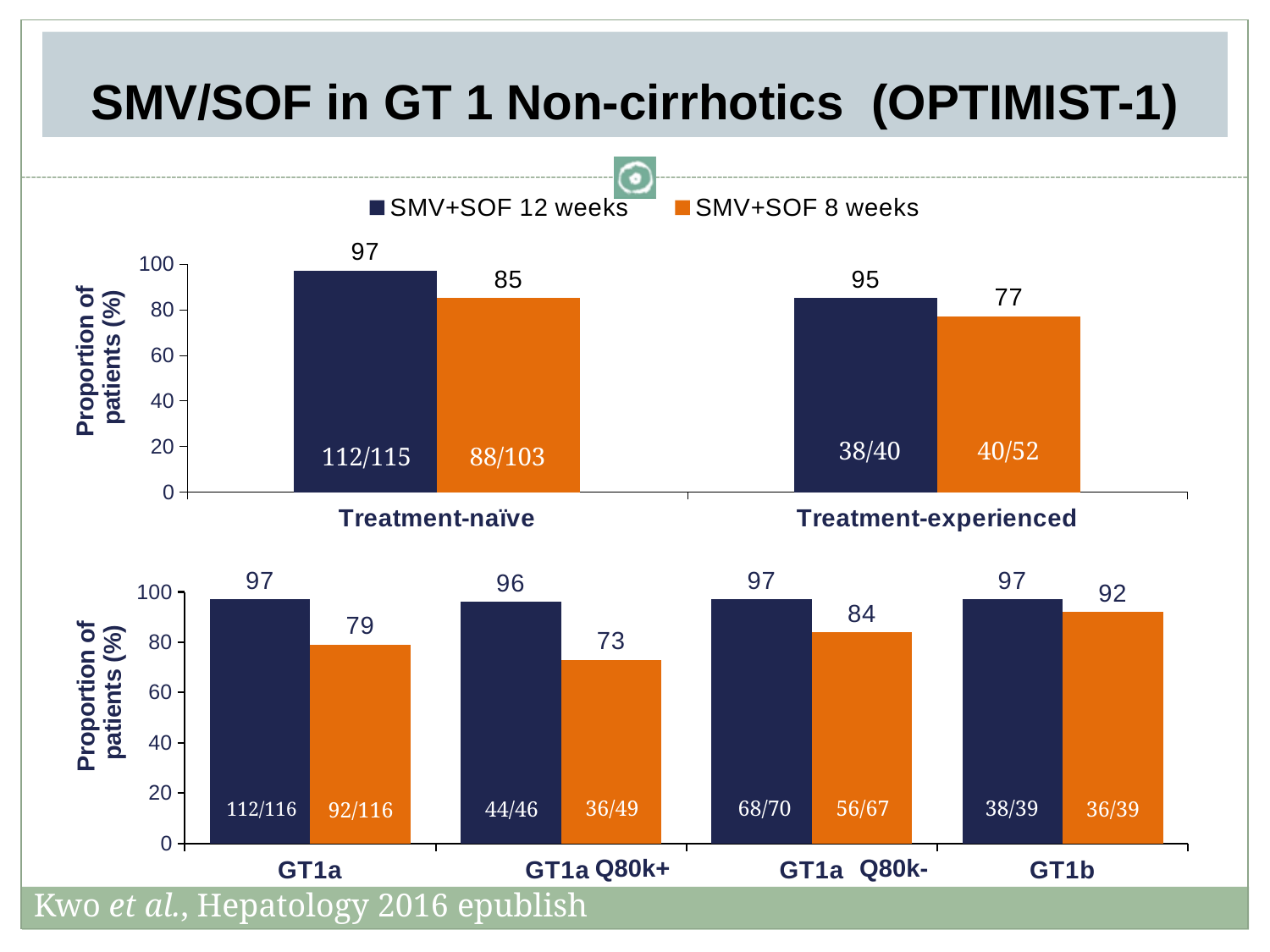
In the top chart, what is the difference between the SMV+SOF 12 weeks and SMV+SOF 8 weeks values for Treatment-naïve patients? 12 In the bottom chart, which category has the lowest SMV+SOF 8 weeks value? GT1a Q80k+ In the top chart, what is the value for SMV+SOF 12 weeks in the Treatment-naïve group? 97 How many series does the legend list? 2 In the bottom chart, how many categories are shown on the x axis? 4 In the bottom chart, what is the value for SMV+SOF 8 weeks in the GT1a Q80k+ group? 73 In the bottom chart, is the SMV+SOF 8 weeks value for GT1b larger or smaller than the SMV+SOF 8 weeks value for GT1a Q80k-? larger In the top chart, what is the value for SMV+SOF 8 weeks in the Treatment-experienced group? 77 In the top chart, how many categories are shown on the x axis? 2 In the bottom chart, which category has the highest SMV+SOF 8 weeks value? GT1b In the bottom chart, what is the difference between the SMV+SOF 12 weeks and SMV+SOF 8 weeks values for GT1a? 18 What type of chart is the bottom chart? bar chart